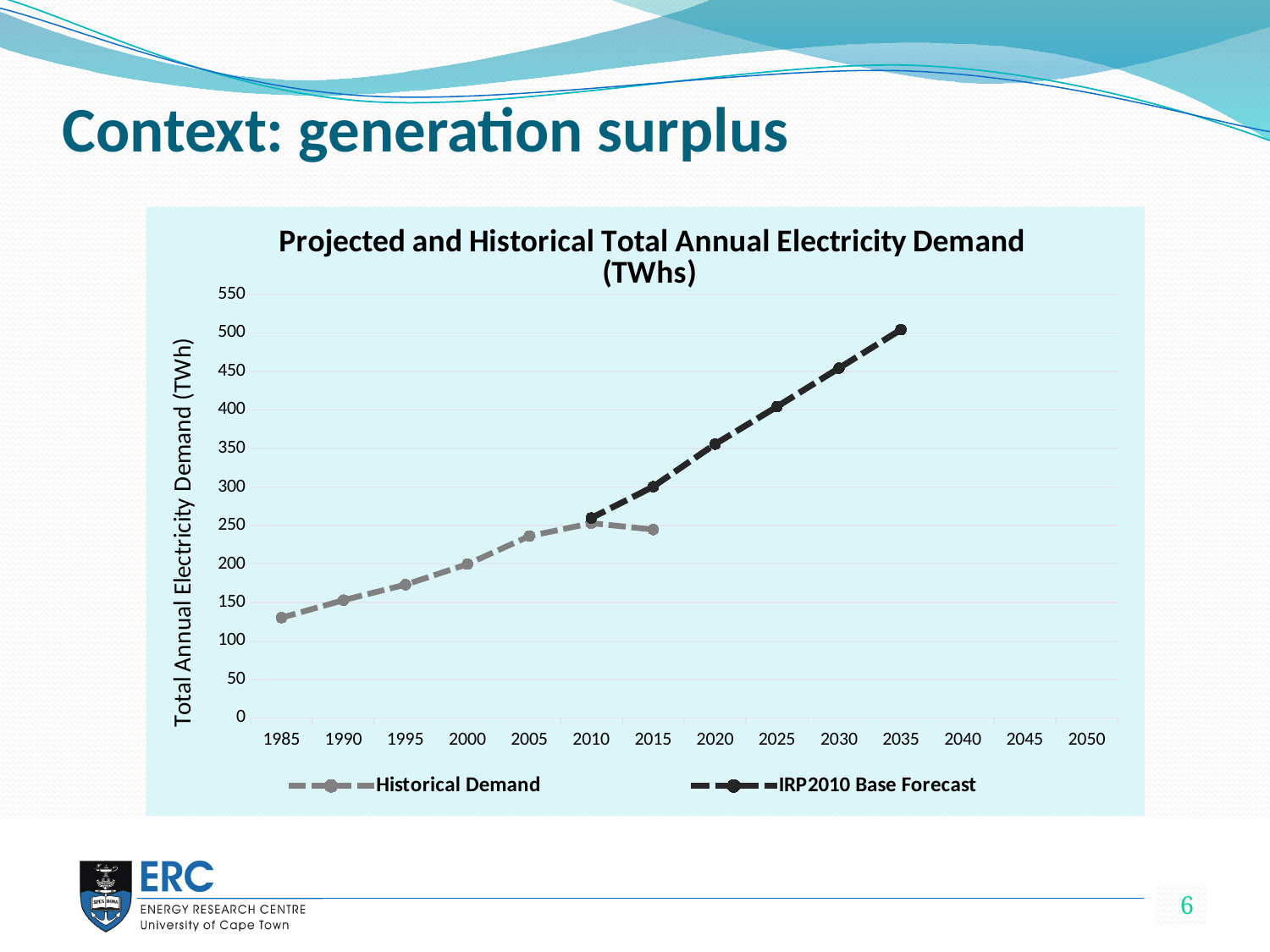
Is the IRP2010 Base Forecast value for 2020 greater or less than 300? greater Does the IRP2010 Base Forecast series rise or fall from 2010 to 2035? rise What is the title of the chart? Projected and Historical Total Annual Electricity Demand (TWhs) Is the Historical Demand value for 1985 greater or less than 150? less In which year does the Historical Demand series have its lowest value? 1985 In which year does the Historical Demand series reach its highest value? 2010 What kind of chart is shown on the slide? line chart In 2015, which series has the larger value: Historical Demand or IRP2010 Base Forecast? IRP2010 Base Forecast In which year does the IRP2010 Base Forecast series reach its highest value? 2035 Is the Historical Demand value for 2005 greater or less than 200? greater How many series does the legend list? 2 What is the label on the vertical axis? Total Annual Electricity Demand (TWh)